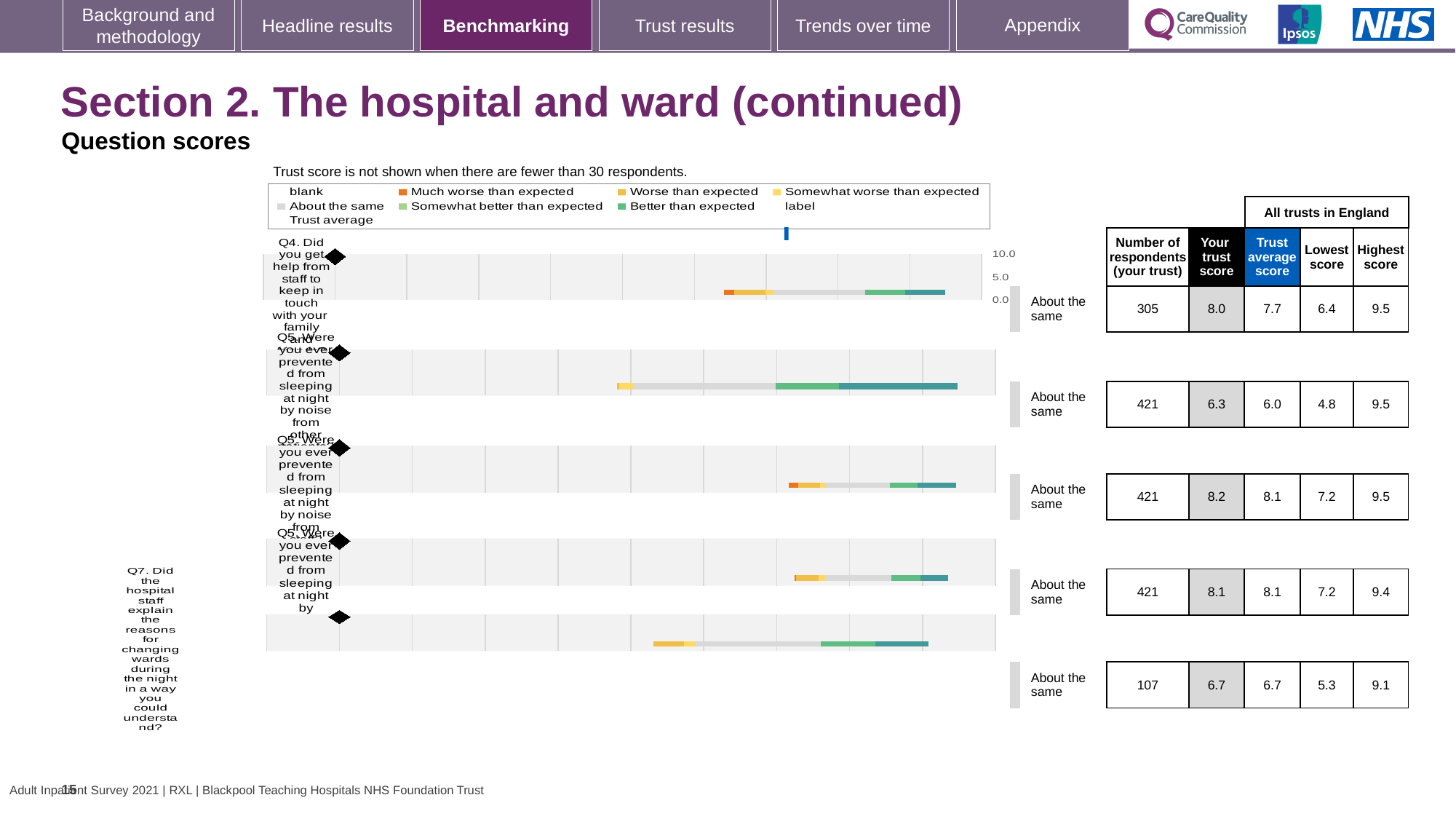
How many question rows (bars) are plotted in the chart? 5 For Q4, how much higher is 'Your trust score' than the 'Trust average score'? 0.3 For Q4, which is larger: 'Your trust score' or the 'Trust average score'? Your trust score What is the 'Lowest score' for Q7 (explaining reasons for changing wards during the night)? 5.3 For the second row of the table (421 respondents, trust score 6.3), what is the difference between the 'Highest score' and the 'Lowest score'? 4.7 What benchmark category is shown next to the Q4 bar? About the same What is 'Your trust score' for Q4 (help from staff to keep in touch with family)? 8.0 How many respondents (your trust) are shown for Q4 (help from staff to keep in touch with family)? 305 What is the highest 'Your trust score' value shown in the table? 8.2 What is the 'Trust average score' for Q7 (explaining reasons for changing wards during the night)? 6.7 What kind of chart is used to show the question scores on this slide? bar chart What is the smallest 'Number of respondents (your trust)' shown in the table? 107